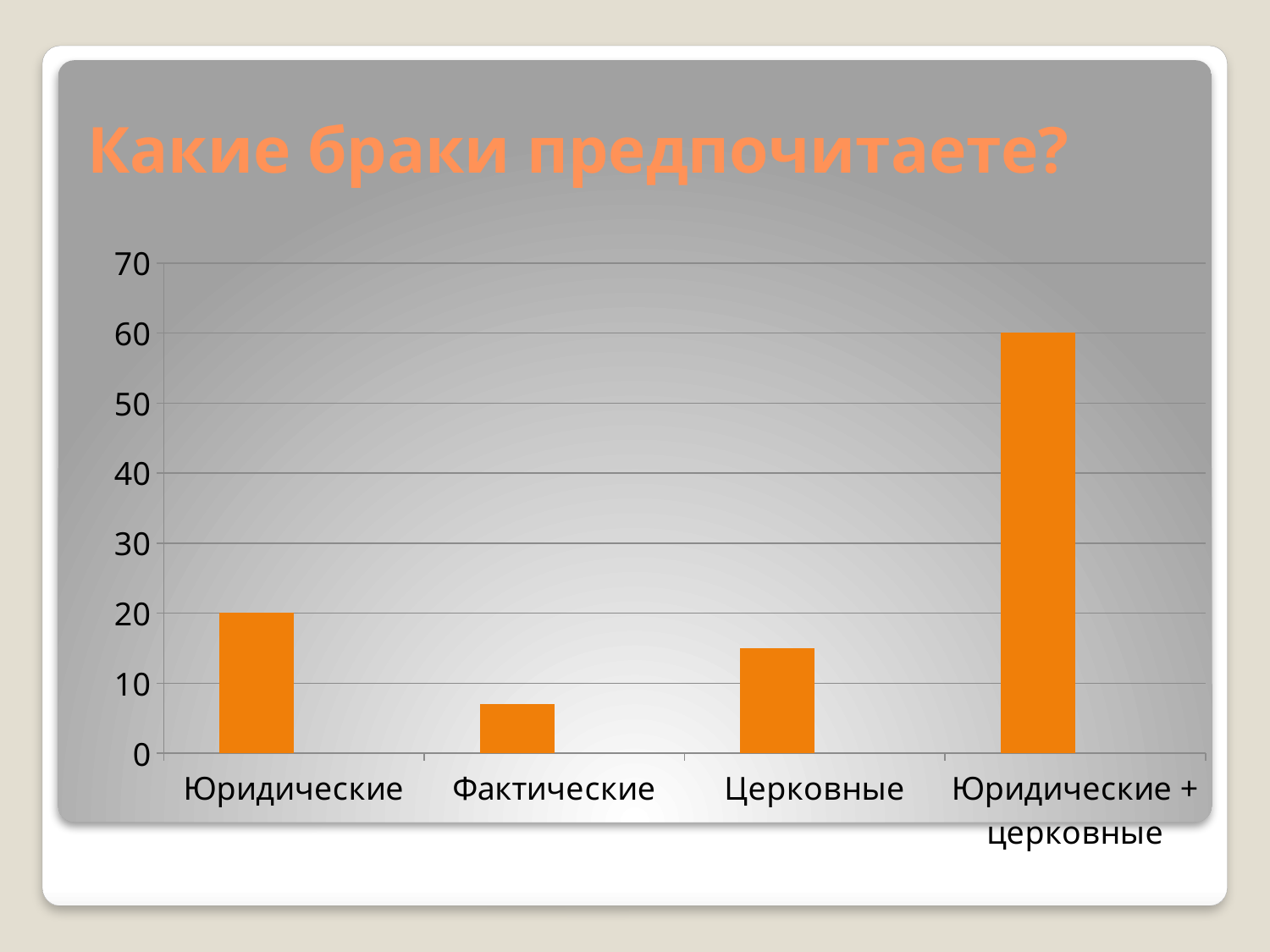
What is the value for Юридические + церковные? 60 What is the value for Юридические? 20 Which is larger, the value for Юридические or the value for Церковные? Юридические Is the value for Церковные greater or less than 10? greater What is the title of the chart on the slide? Какие браки предпочитаете? Which category has the lowest bar? Фактические Is the value for Фактические greater or less than 10? less How many categories are shown on the x axis of the chart? 4 What colour are the bars in the chart? orange What kind of chart is shown on the slide? bar chart Which category has the highest bar? Юридические + церковные What is the difference between the values for Юридические + церковные and Юридические? 40